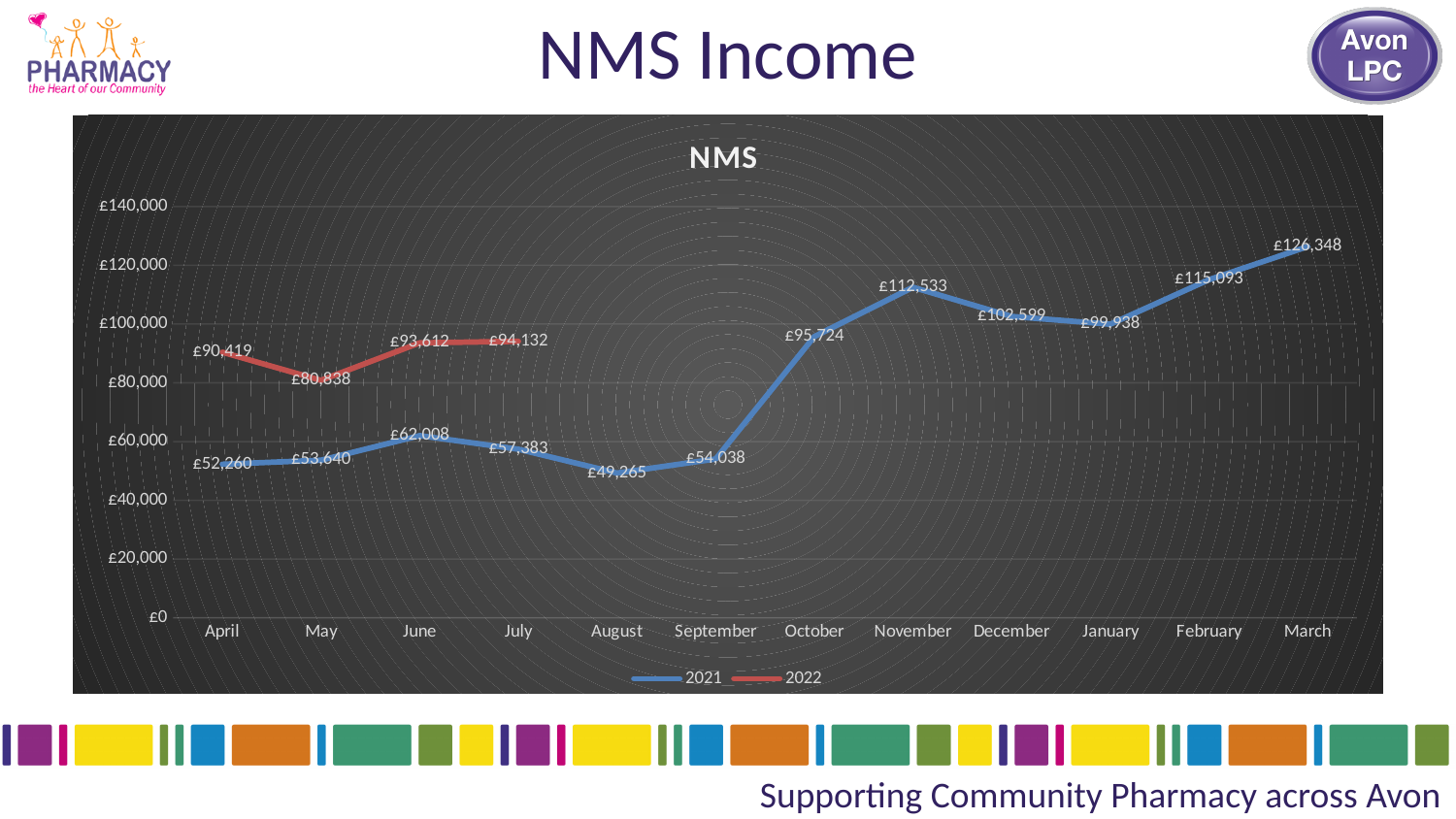
Is the 2021 value for December greater or less than £100,000? greater Which is larger, the 2021 value for November or the 2021 value for February? February What is the 2021 value for October? £95,724 What is the title of the chart? NMS What is the difference between the 2022 and 2021 values for April? £38,159 How many months are shown on the x axis? 12 What is the 2022 value for May? £80,838 What kind of chart is shown? line chart Which month has the lowest 2021 value? August Which month has the highest 2021 value? March How many series does the legend list? 2 What is the 2021 value for August? £49,265